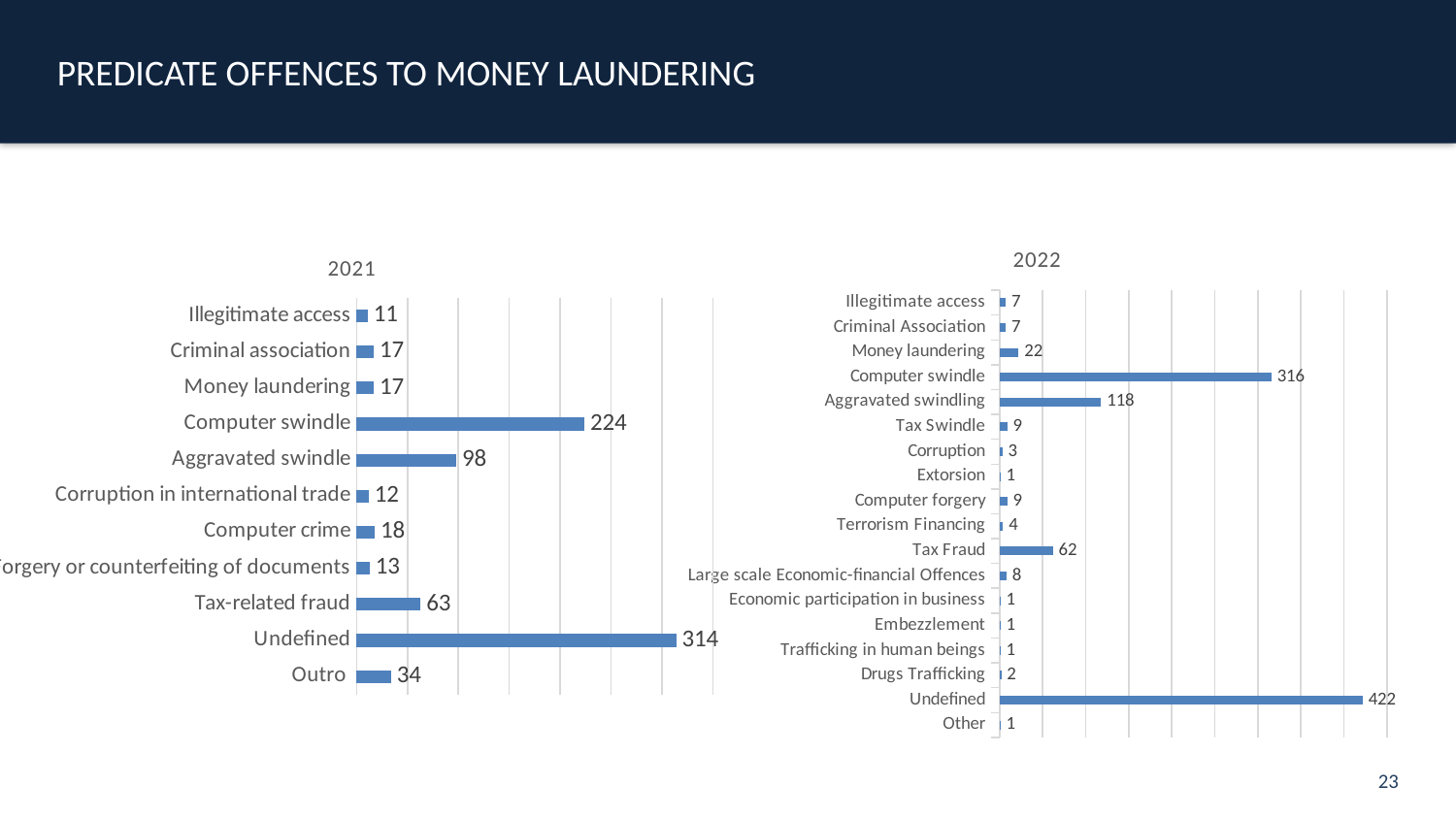
In the 2022 chart, which is larger: Money laundering or Tax Fraud? Tax Fraud In the 2022 chart, what is the value for Aggravated swindling? 118 In the 2022 chart, what is the difference between Computer swindle and Tax Fraud? 254 In the 2021 chart, which category has the lowest value? Illegitimate access How many categories are shown in the 2022 chart? 18 In the 2021 chart, which category has the highest value? Undefined How many categories are shown in the 2021 chart? 11 What type of chart is the 2021 chart? Bar chart In the 2021 chart, which is larger: Aggravated swindle or Tax-related fraud? Aggravated swindle In the 2021 chart, what is the difference between Undefined and Computer swindle? 90 In the 2022 chart, which category has the highest value? Undefined In the 2021 chart, what is the value for Computer swindle? 224